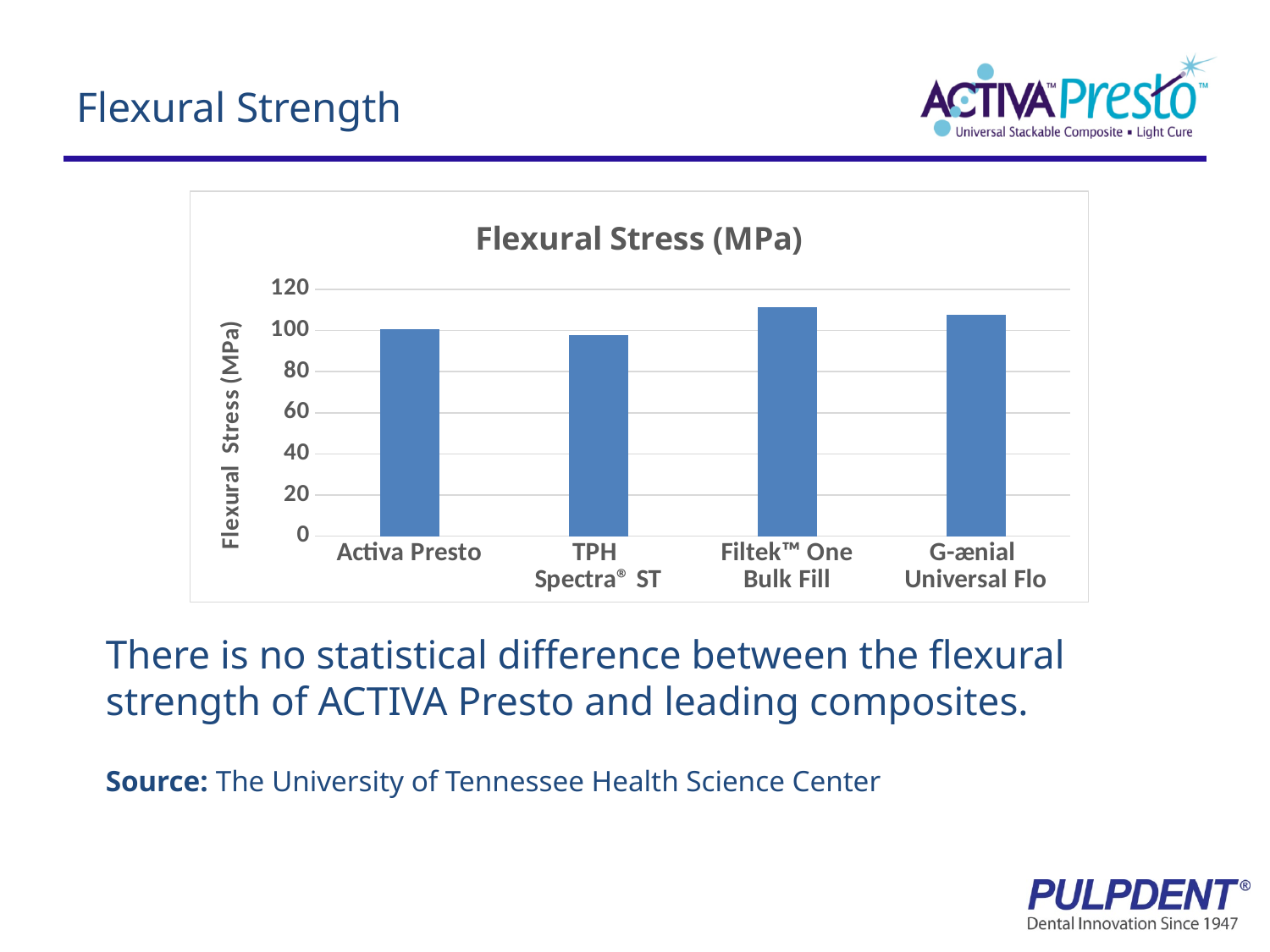
Is the value for G-ænial Universal Flo greater or less than 100? greater How many composites (categories) are plotted in the Flexural Stress (MPa) chart? 4 What is the label on the vertical axis of the chart? Flexural Stress (MPa) What is the title of the chart? Flexural Stress (MPa) Is the value for Activa Presto greater or less than 80? greater Which has the larger flexural stress, Filtek™ One Bulk Fill or TPH Spectra® ST? Filtek™ One Bulk Fill Which has the larger flexural stress, Filtek™ One Bulk Fill or Activa Presto? Filtek™ One Bulk Fill Is the value for TPH Spectra® ST greater or less than 100? less What kind of chart is shown on the slide? bar chart Which has the larger flexural stress, G-ænial Universal Flo or TPH Spectra® ST? G-ænial Universal Flo